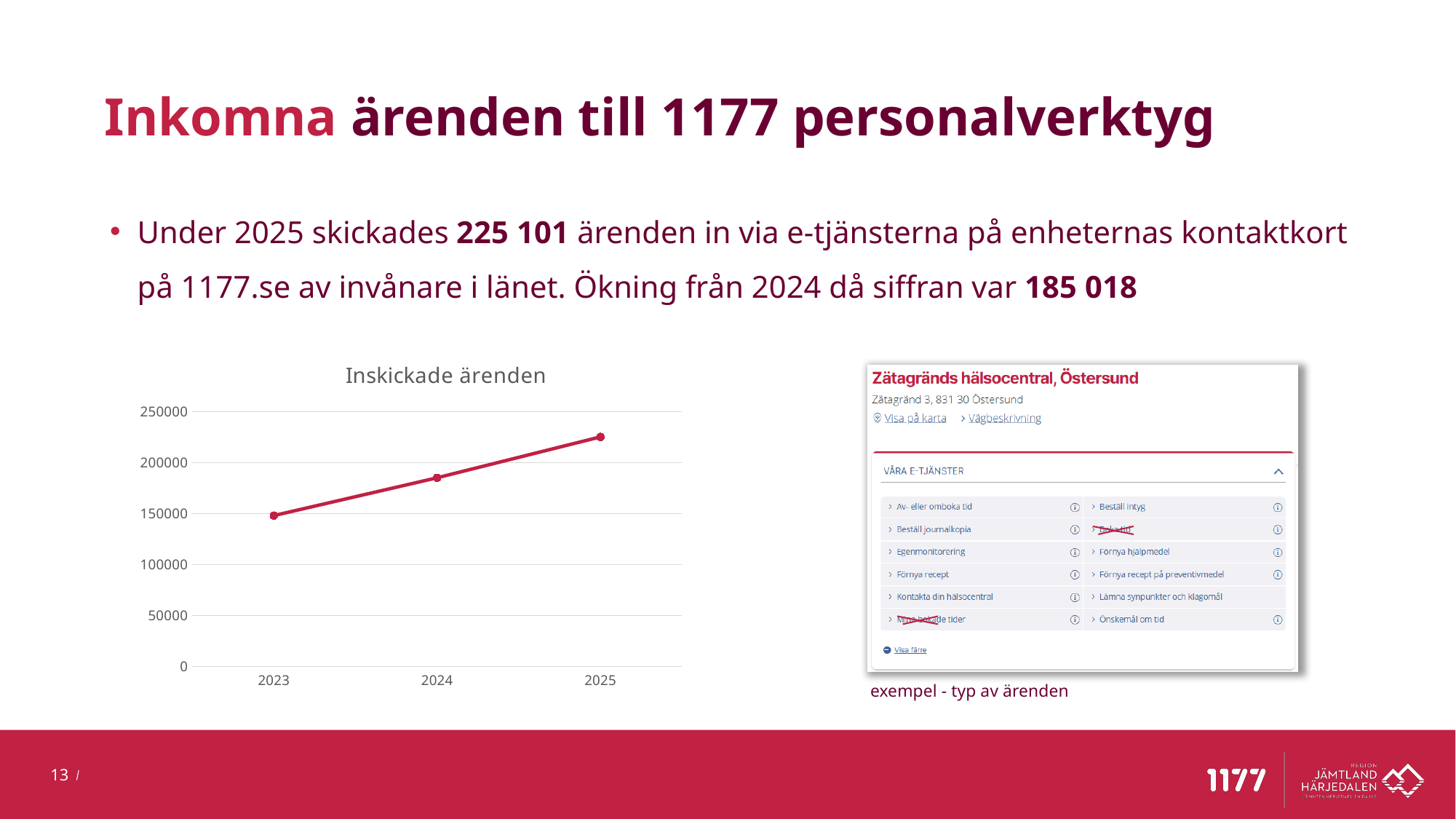
Is the value for 2023 greater or less than 100000? greater Do the values in the chart rise or fall from 2023 to 2025? rise Is the value for 2025 greater or less than 200000? greater How many years are plotted on the x axis of the chart? 3 According to the slide, how many ärenden were submitted in 2024? 185 018 According to the slide, how many ärenden were submitted in 2025? 225 101 What kind of chart is shown on the slide? line chart What is the title of the chart? Inskickade ärenden Which year has the lowest value in the chart? 2023 Which year has the highest value in the chart? 2025 Which year has the larger value, 2024 or 2025? 2025 Is the value for 2024 greater or less than 200000? less